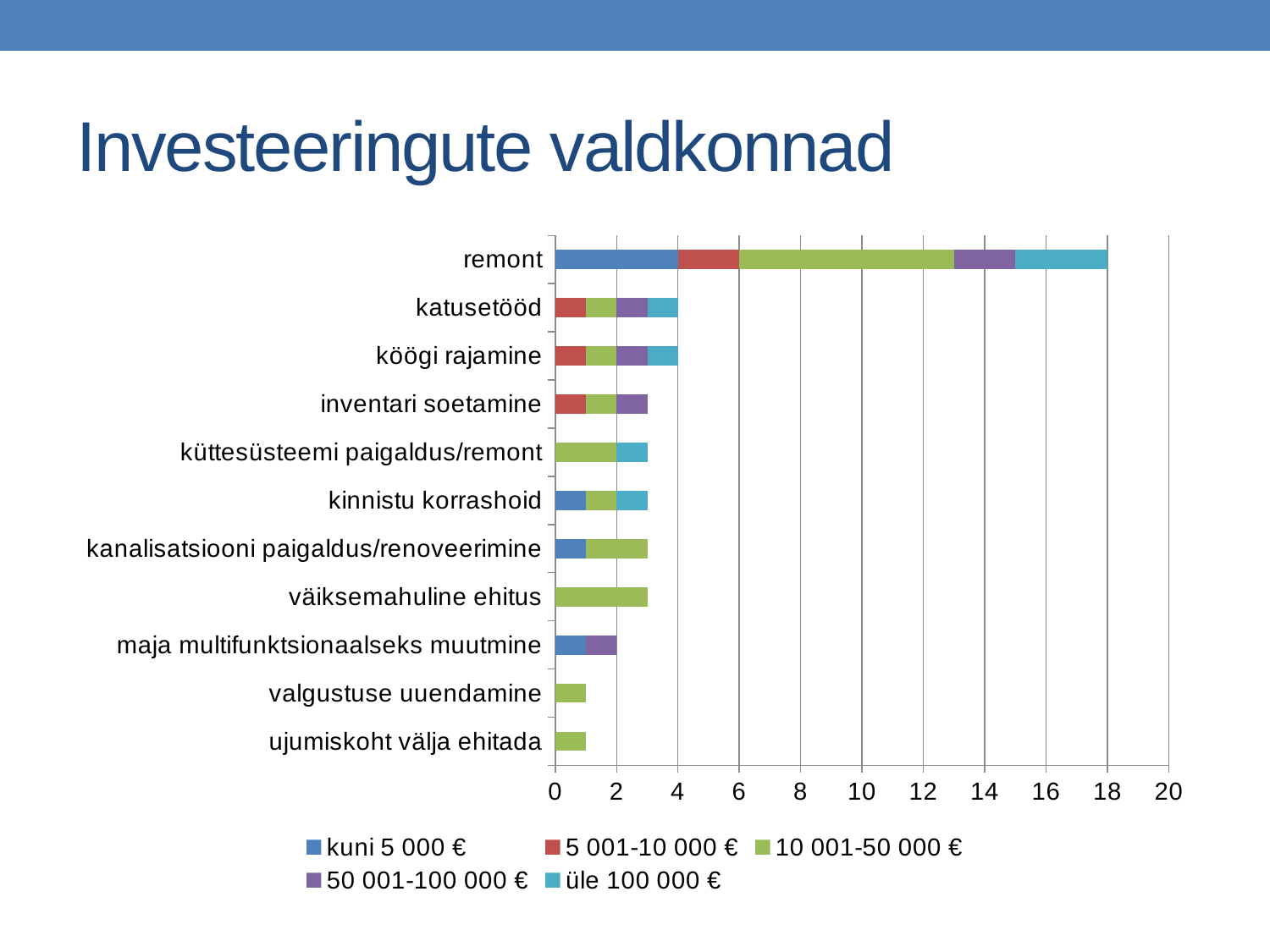
How many series does the legend list? 5 How many categories are plotted on the chart? 11 What is the total length of the stacked bar for katusetööd? 4 What kind of chart is shown on the slide? Stacked bar chart What is the total length of the stacked bar for remont? 18 Which category has the longest total bar? remont What is the difference between the total bar for remont and the total bar for katusetööd? 14 Is the total bar for väiksemahuline ehitus greater or less than 4? less What is the title of the chart on the slide? Investeeringute valdkonnad Which legend entry is shown in blue (the first series)? kuni 5 000 € Which has the longer total bar, köögi rajamine or valgustuse uuendamine? köögi rajamine What is the value of the 'kuni 5 000 €' segment for remont? 4